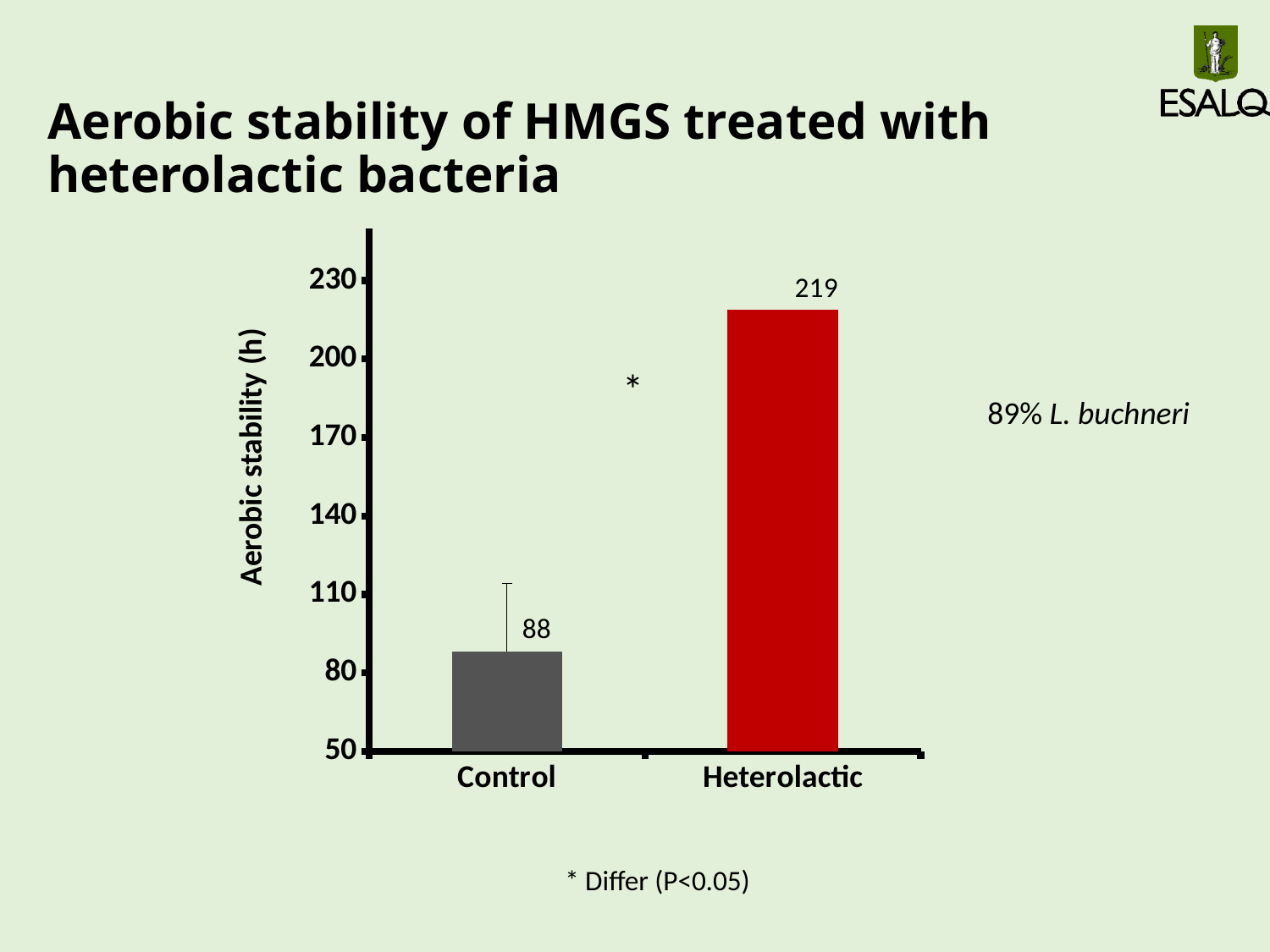
What is the aerobic stability value for Heterolactic? 219 Which category has the highest aerobic stability? Heterolactic Which has a larger aerobic stability value, Control or Heterolactic? Heterolactic Is the value for Control greater or less than 110? less What kind of chart is shown on the slide? bar chart What is the aerobic stability value for Control? 88 How many categories are shown on the x axis? 2 What is the label of the y axis? Aerobic stability (h) Which category has the lowest aerobic stability? Control Is the value for Heterolactic greater or less than 200? greater What is the difference in aerobic stability between Heterolactic and Control? 131 What colour is the Heterolactic bar? red